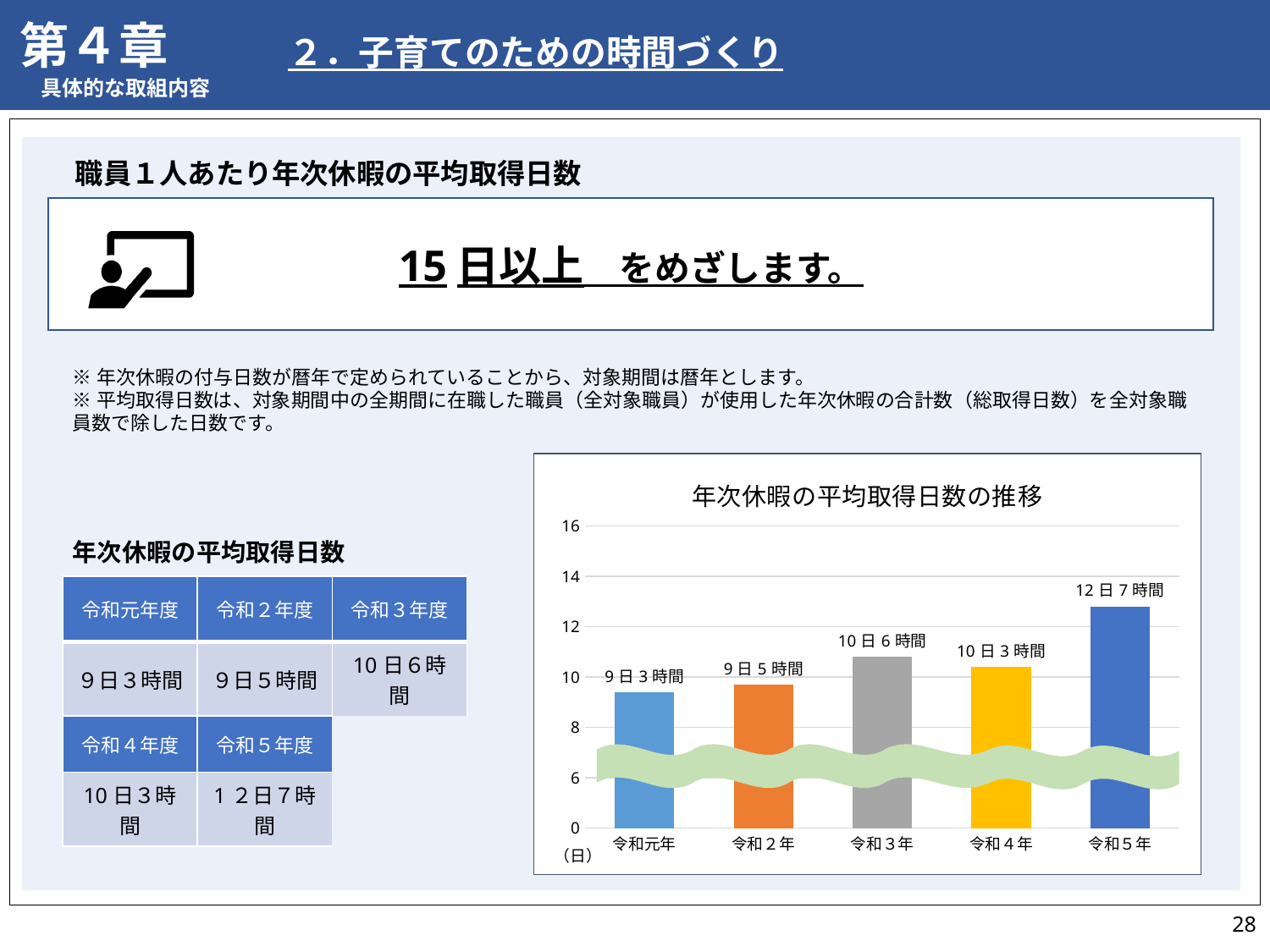
How many years (categories) are plotted in the chart? 5 What is the value shown for 令和３年 in the chart? 10日6時間 What is the value shown for 令和元年 in the chart? 9日3時間 What is the value shown for 令和２年 in the chart? 9日5時間 Which is larger, the value for 令和３年 or the value for 令和４年? 令和３年 What kind of chart is shown on the slide? bar chart What is the title of the chart? 年次休暇の平均取得日数の推移 Is the value for 令和元年 greater or less than 10? less Which year has the lowest average number of annual leave days taken? 令和元年 What is the value shown for 令和４年 in the chart? 10日3時間 What is the value shown for 令和５年 in the chart? 12日7時間 Which year has the highest average number of annual leave days taken? 令和５年